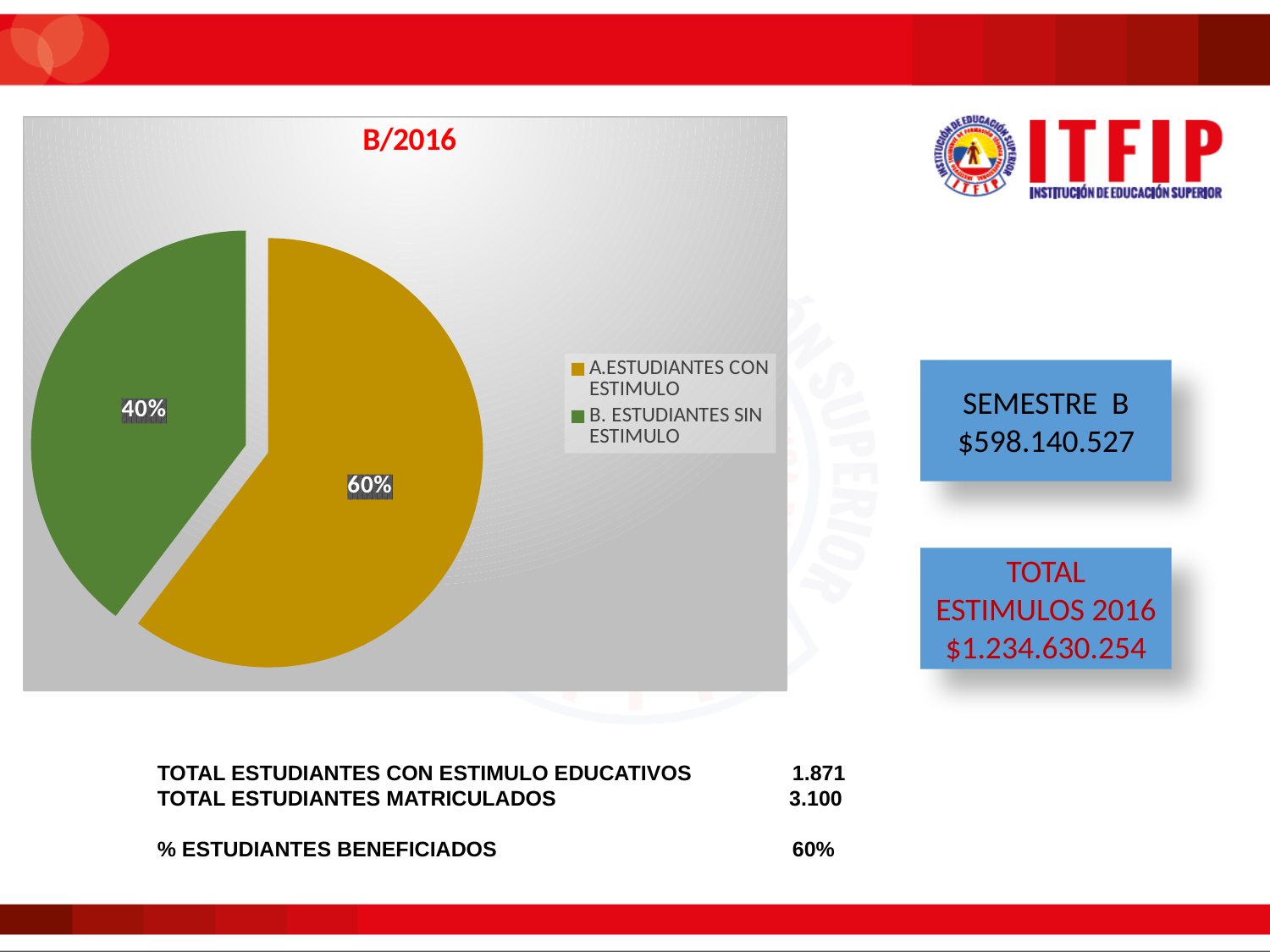
Which is larger, the A.ESTUDIANTES CON ESTIMULO slice or the B. ESTUDIANTES SIN ESTIMULO slice? A.ESTUDIANTES CON ESTIMULO How many entries does the legend of the pie chart list? 2 What is the difference in percentage points between the A.ESTUDIANTES CON ESTIMULO slice and the B. ESTUDIANTES SIN ESTIMULO slice? 20% What share of the pie does B. ESTUDIANTES SIN ESTIMULO represent? 40% How many slices does the pie chart have? 2 What share of the pie does A.ESTUDIANTES CON ESTIMULO represent? 60% What is the title of the pie chart? B/2016 What colour is the slice for B. ESTUDIANTES SIN ESTIMULO in the pie chart? green Which slice of the pie chart is the smallest? B. ESTUDIANTES SIN ESTIMULO What kind of chart is shown on the slide? pie chart Is the share for B. ESTUDIANTES SIN ESTIMULO greater or less than 50%? less Which slice of the pie chart is the largest? A.ESTUDIANTES CON ESTIMULO